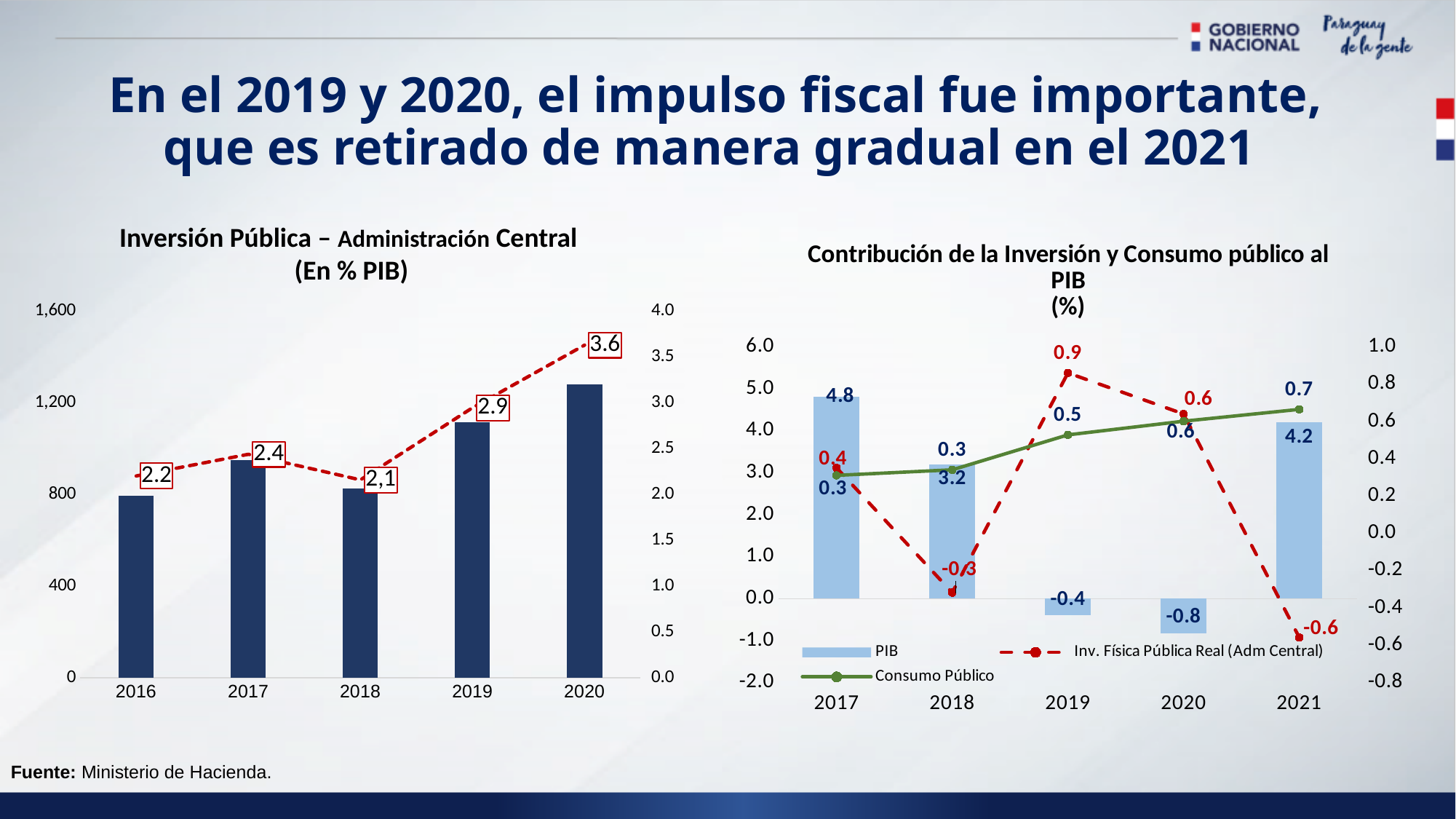
In the right chart (Contribución de la Inversión y Consumo público al PIB), what is the PIB value for 2017? 4.8 In the right chart (Contribución de la Inversión y Consumo público al PIB), what is the Inv. Física Pública Real (Adm Central) value for 2021? -0.6 In the right chart (Contribución de la Inversión y Consumo público al PIB), which year has the lowest PIB value? 2020 In the left chart (Inversión Pública – Administración Central), what value does the dashed line show for 2020? 3.6 In the left chart (Inversión Pública – Administración Central), which year has the highest value on the dashed line? 2020 In the right chart (Contribución de la Inversión y Consumo público al PIB), what is the Consumo Público value for 2019? 0.5 In the left chart (Inversión Pública – Administración Central), how many years are shown on the x axis? 5 In the left chart (Inversión Pública – Administración Central), is the bar for 2020 greater or less than 1,200? greater In the right chart (Contribución de la Inversión y Consumo público al PIB), does the Consumo Público line rise or fall from 2017 to 2021? rise In the left chart (Inversión Pública – Administración Central), what value does the dashed line show for 2018? 2,1 In the right chart (Contribución de la Inversión y Consumo público al PIB), what is the difference between the PIB values for 2017 and 2021? 0.6 In the right chart (Contribución de la Inversión y Consumo público al PIB), how many series does the legend list? 3